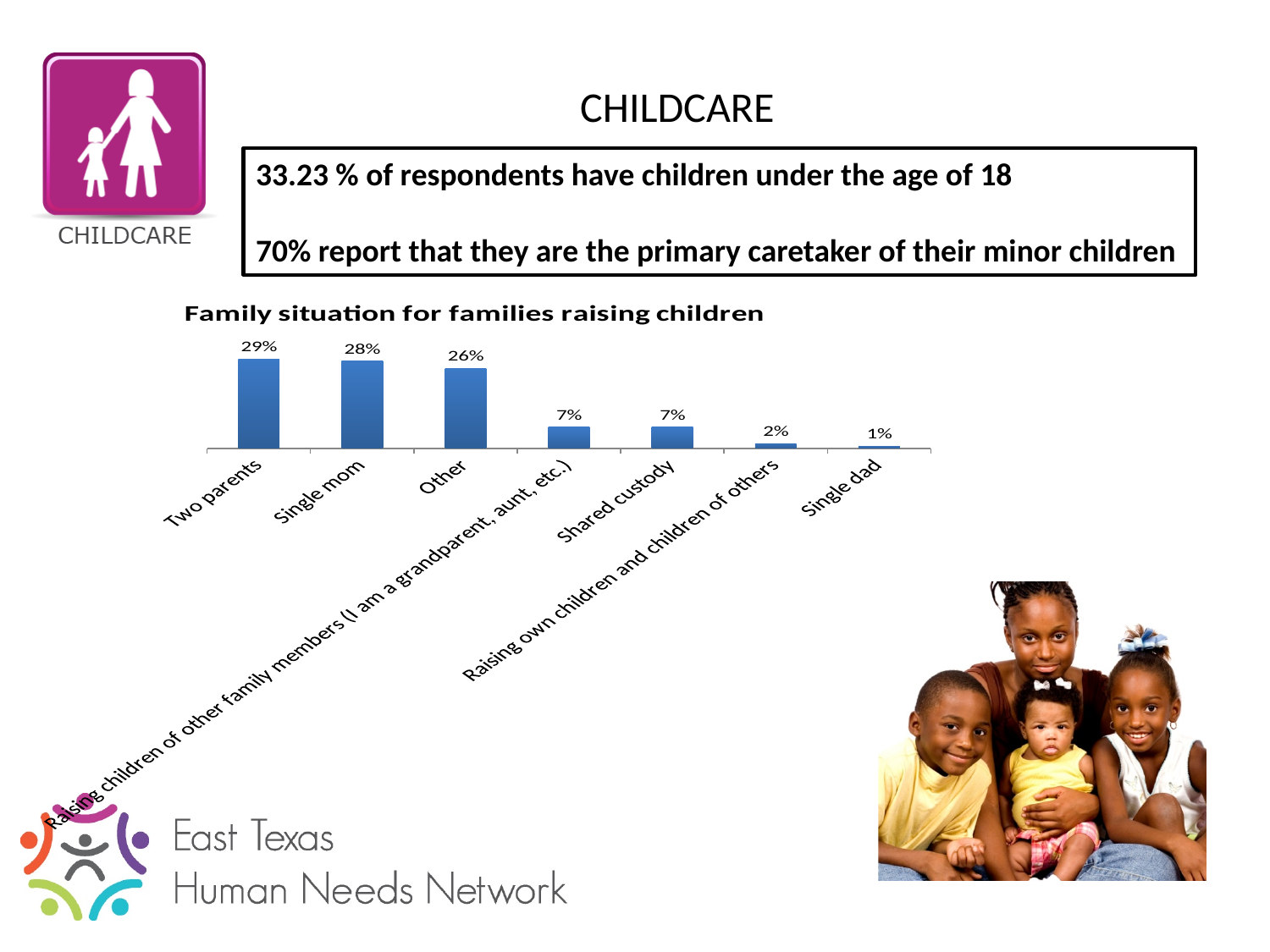
What is the value for Two parents? 29% What is the title of the chart? Family situation for families raising children Which category has the highest value? Two parents How many categories are shown in the chart? 7 What is the difference between the values for Two parents and Other? 3% What kind of chart is shown on the slide? Bar chart What is the value for Single mom? 28% What is the value for Single dad? 1% Which is larger, the value for Single mom or the value for Shared custody? Single mom What is the value for Other? 26% Which category has the lowest value? Single dad What is the value for Shared custody? 7%